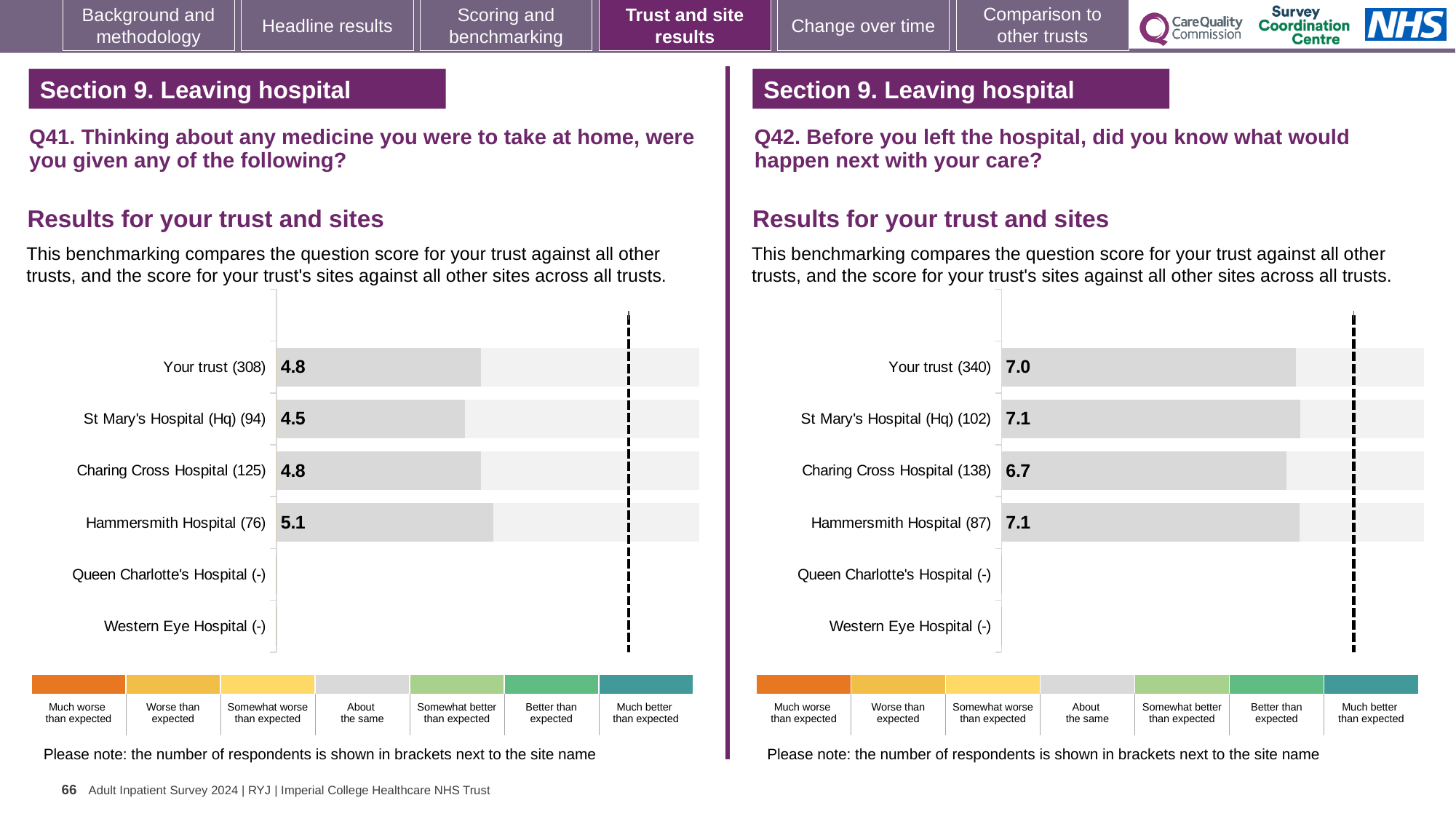
In the Q41 chart on the left, which site has the highest score? Hammersmith Hospital In the Q42 chart on the right, what is the score for Your trust? 7.0 In the Q41 chart on the left, what is the score for Your trust? 4.8 In the Q41 chart on the left, what is the difference between the scores for Hammersmith Hospital and St Mary's Hospital (Hq)? 0.6 How many sites (including Your trust) are listed on the y axis of the Q41 chart on the left? 6 What kind of chart is the Q42 chart on the right? Bar chart In the Q42 chart on the right, which is larger: the score for St Mary's Hospital (Hq) or the score for Charing Cross Hospital? St Mary's Hospital (Hq) In the Q41 chart on the left, what is the score for St Mary's Hospital (Hq)? 4.5 In the Q41 chart on the left, which site has the lowest score? St Mary's Hospital (Hq) In the Q42 chart on the right, which site has the lowest score? Charing Cross Hospital In the Q42 chart on the right, what is the difference between the scores for Hammersmith Hospital and Your trust? 0.1 In the Q42 chart on the right, what is the score for Charing Cross Hospital? 6.7